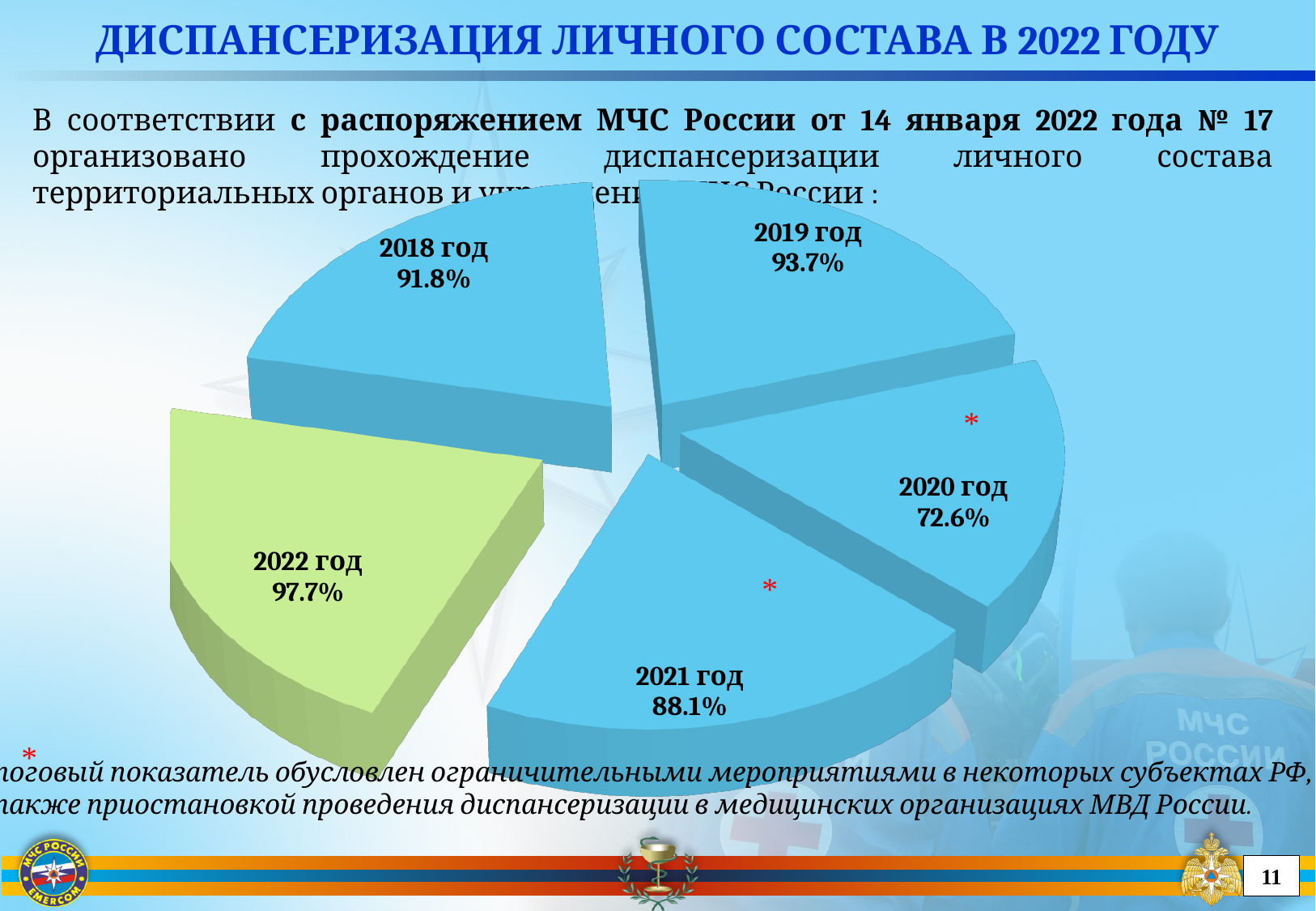
What is the value shown for 2018 год? 91.8% What is the value shown for 2022 год? 97.7% Which slice of the pie chart is coloured green rather than blue? 2022 год Which is larger, the value for 2019 год or the value for 2021 год? 2019 год What is the value shown for 2020 год? 72.6% Which year has the lowest value on the chart? 2020 год Which year has the highest value on the chart? 2022 год What is the value shown for 2019 год? 93.7% What kind of chart is shown on the slide? pie chart What is the value shown for 2021 год? 88.1% How many slices does the pie chart have? 5 What is the difference between the values for 2022 год and 2020 год? 25.1%